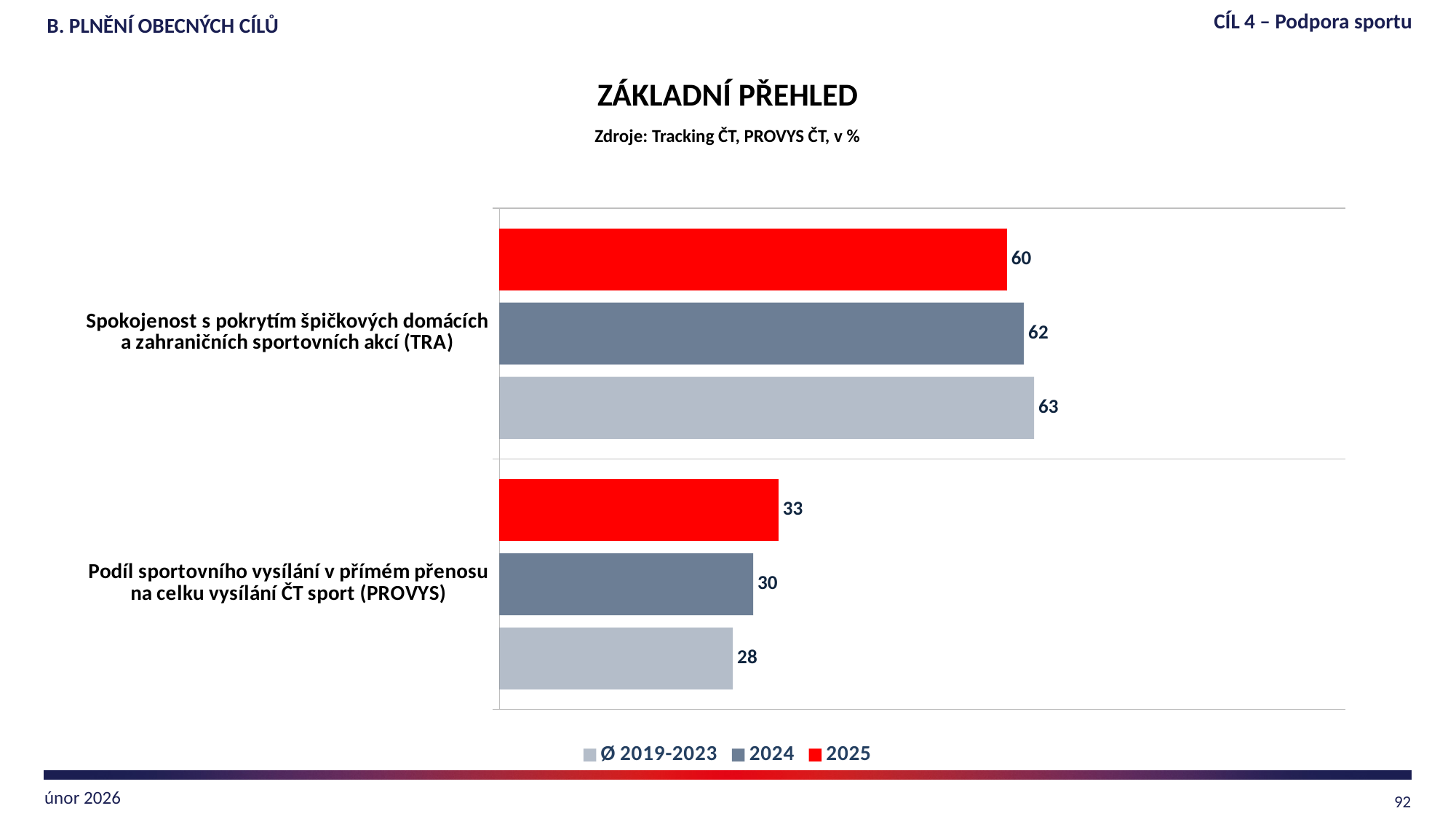
Which is larger for 'Podíl sportovního vysílání v přímém přenosu na celku vysílání ČT sport (PROVYS)': the 2025 value or the Ø 2019-2023 value? 2025 How many series does the legend list? 3 What is the Ø 2019-2023 value for 'Podíl sportovního vysílání v přímém přenosu na celku vysílání ČT sport (PROVYS)'? 28 Which colour represents the 2025 series in the chart? Red Which series has the lowest value for 'Podíl sportovního vysílání v přímém přenosu na celku vysílání ČT sport (PROVYS)'? Ø 2019-2023 What is the difference between the Ø 2019-2023 and 2025 values for 'Spokojenost s pokrytím špičkových domácích a zahraničních sportovních akcí (TRA)'? 3 What is the 2025 value for 'Spokojenost s pokrytím špičkových domácích a zahraničních sportovních akcí (TRA)'? 60 What is the 2024 value for 'Podíl sportovního vysílání v přímém přenosu na celku vysílání ČT sport (PROVYS)'? 30 What is the Ø 2019-2023 value for 'Spokojenost s pokrytím špičkových domácích a zahraničních sportovních akcí (TRA)'? 63 Which series has the highest value for 'Spokojenost s pokrytím špičkových domácích a zahraničních sportovních akcí (TRA)'? Ø 2019-2023 What is the difference between the 2025 and 2024 values for 'Podíl sportovního vysílání v přímém přenosu na celku vysílání ČT sport (PROVYS)'? 3 What kind of chart is shown on the slide? Bar chart